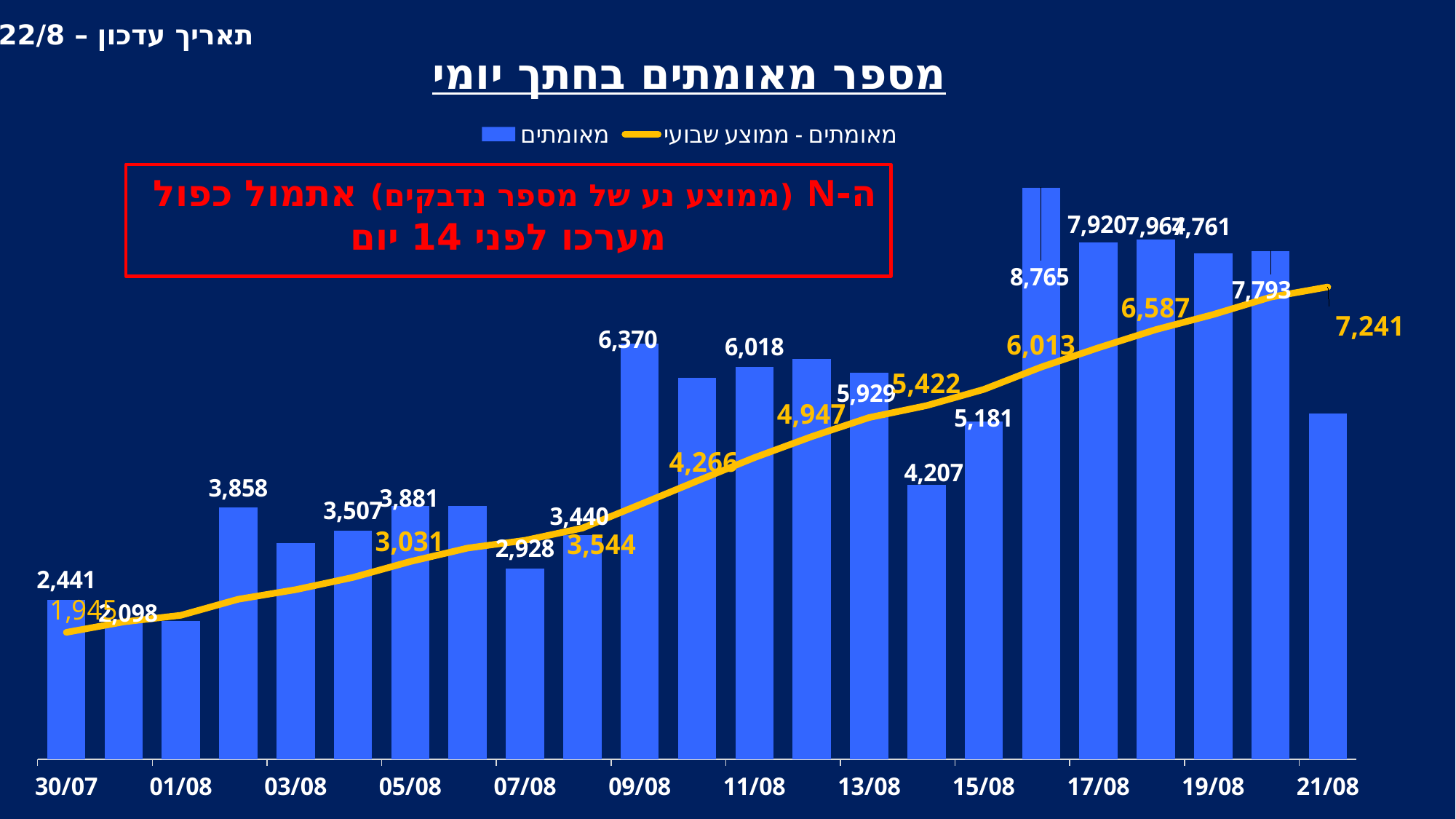
Which date has the larger bar value, 09/08 or 11/08? 09/08 What kind of chart is shown on the slide? bar chart with a line What is the difference between the bar values for 09/08 and 11/08? 352 What is the daily confirmed-cases value (bar) for 09/08? 6,370 What is the daily confirmed-cases value (bar) for 11/08? 6,018 How many series does the legend list? 2 What is the daily confirmed-cases value (bar) for 30/07? 2,441 How many bars (days) are plotted on the chart? 23 What is the last value labelled on the weekly-average line (at 21/08)? 7,241 What is the first value labelled on the weekly-average line (at 30/07)? 1,945 What is the highest daily confirmed-cases value shown on any bar? 8,765 Does the weekly-average line rise or fall from 30/07 to 21/08? rise